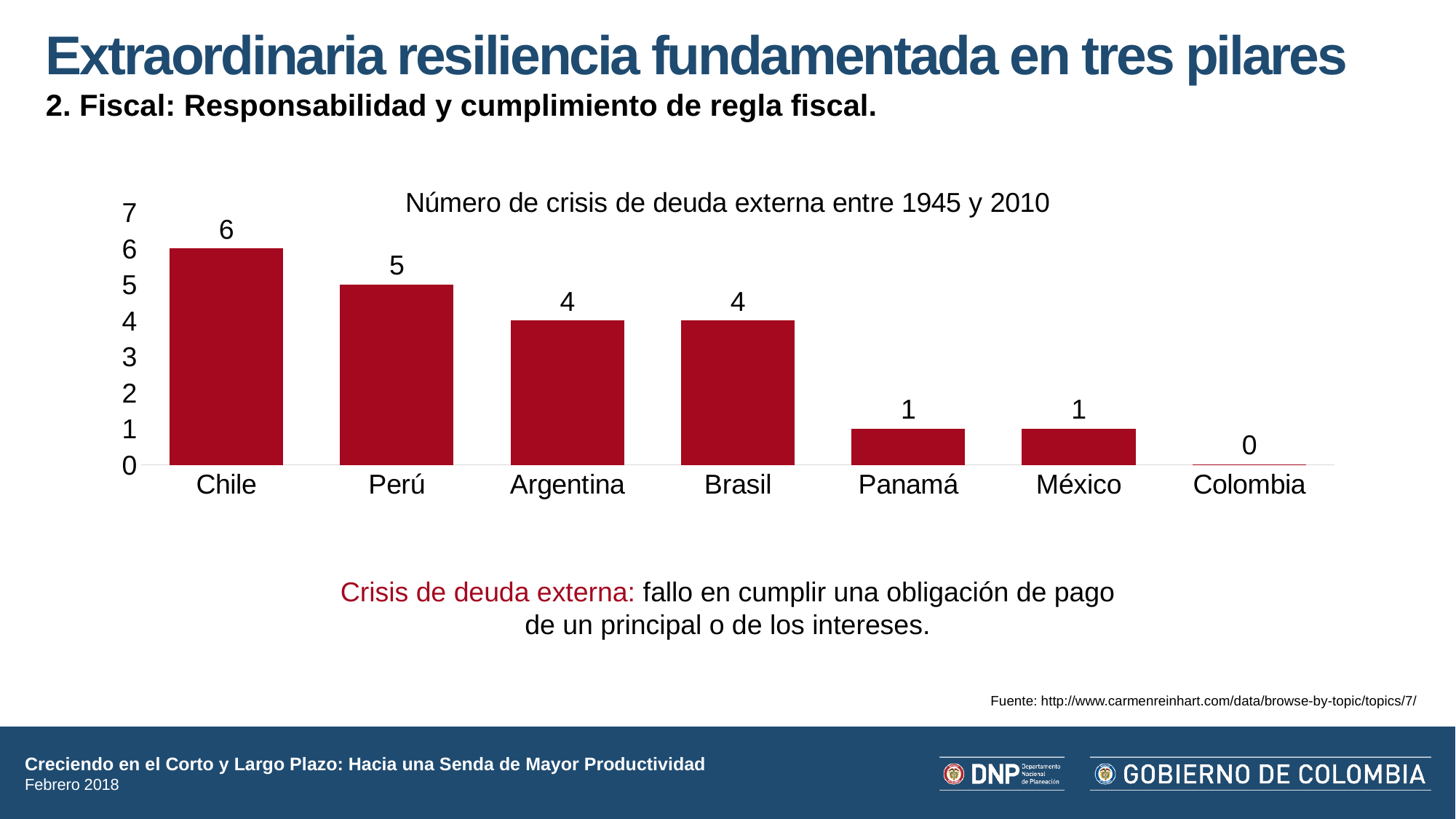
Do the values generally rise or fall from left to right along the x axis? Fall What value is shown for Perú? 5 What kind of chart is shown on the slide? Bar chart What is the number of external debt crises shown for Chile? 6 Which country has the highest number of external debt crises? Chile What is the highest value shown on the vertical axis? 7 Which has a larger value, Perú or Panamá? Perú How many countries are shown on the x axis? 7 Which country has the lowest number of external debt crises? Colombia What is the title of the chart? Número de crisis de deuda externa entre 1945 y 2010 What value is shown for Colombia? 0 What is the difference between the values for Chile and Brasil? 2